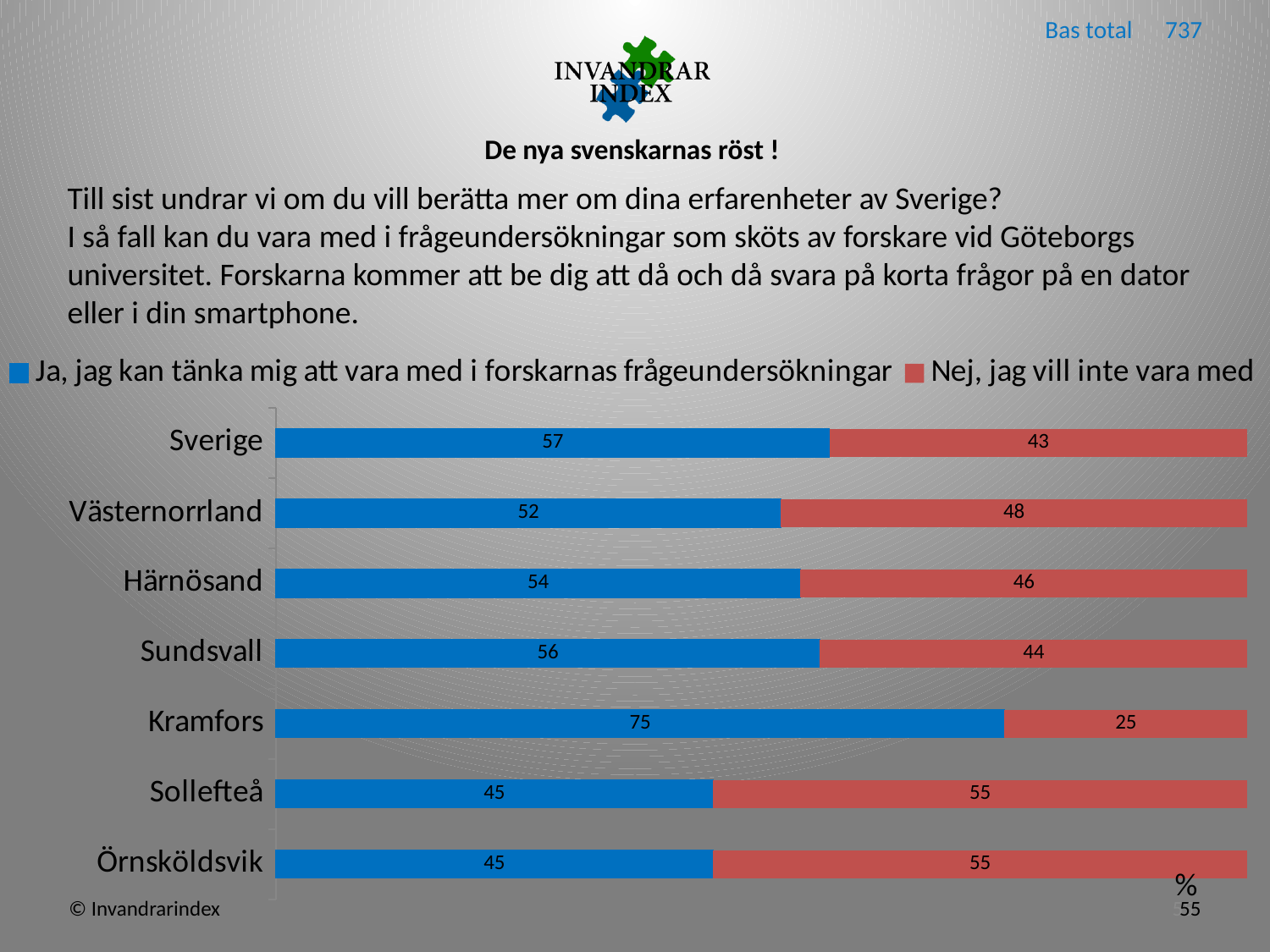
What is the value for Sverige in the 'Ja, jag kan tänka mig att vara med i forskarnas frågeundersökningar' series? 57 Which category has the highest value in the 'Ja, jag kan tänka mig att vara med i forskarnas frågeundersökningar' series? Kramfors What is the difference between the 'Ja' values for Kramfors and Sundsvall? 19 How many categories are shown on the chart? 7 Which category has the lowest value in the 'Nej, jag vill inte vara med' series? Kramfors Which is larger: the 'Nej, jag vill inte vara med' value for Västernorrland or for Härnösand? Västernorrland What colour represents the 'Nej, jag vill inte vara med' series? Red What is the value for Kramfors in the 'Ja, jag kan tänka mig att vara med i forskarnas frågeundersökningar' series? 75 How many series does the legend list? 2 What is the total of the stacked bar for Härnösand? 100 What kind of chart is shown on the slide? Stacked bar chart What is the value for Sollefteå in the 'Nej, jag vill inte vara med' series? 55